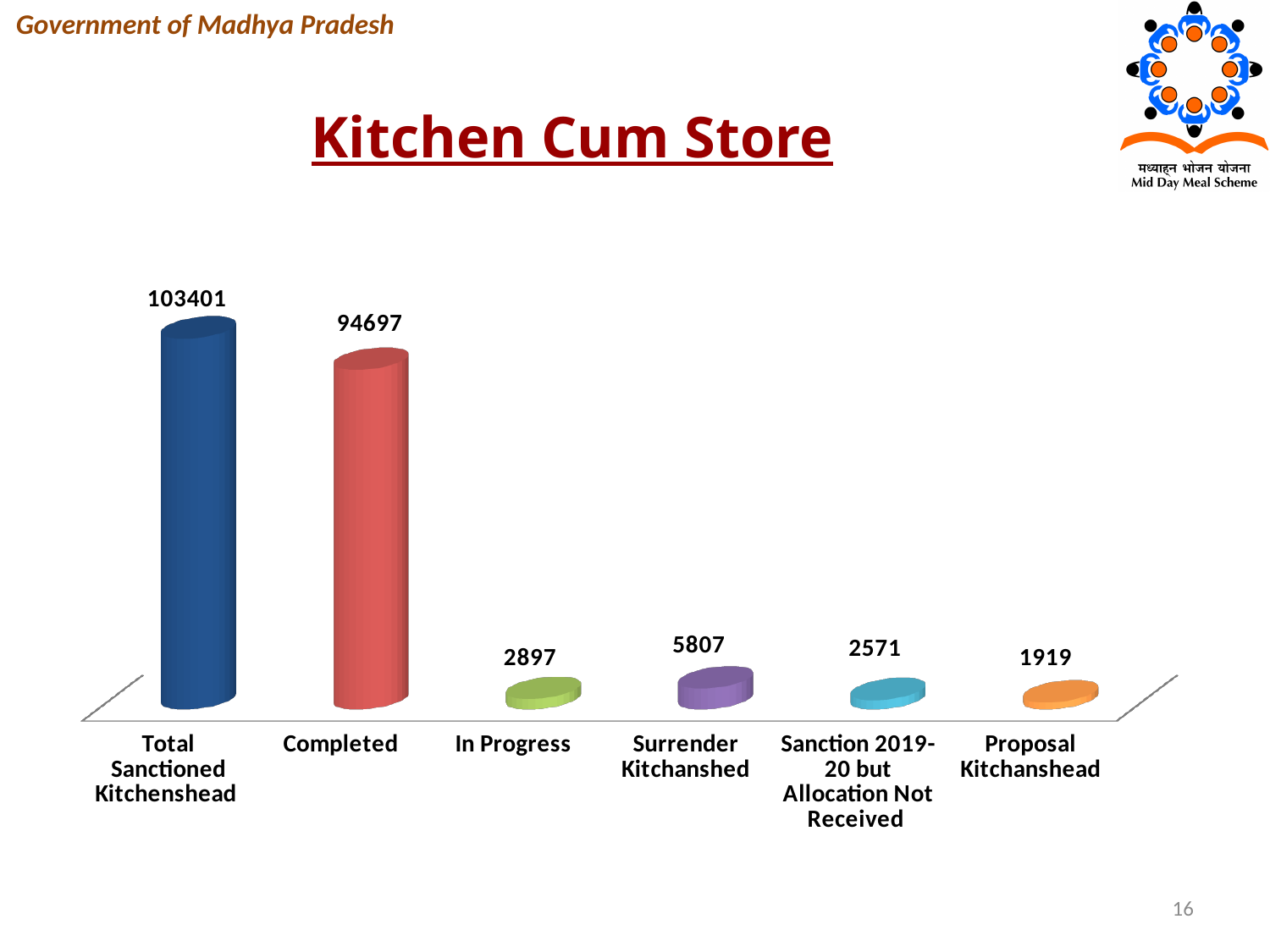
How many categories are shown in the chart? 6 What is the value for Surrender Kitchanshed? 5807 What is the value for In Progress? 2897 What is the value for Proposal Kitchanshead? 1919 What is the difference between Total Sanctioned Kitchenshead and Completed? 8704 Which is larger, Sanction 2019-20 but Allocation Not Received or In Progress? In Progress What is the value for Total Sanctioned Kitchenshead? 103401 What is the difference between Surrender Kitchanshed and In Progress? 2910 Which category has the lowest value? Proposal Kitchanshead Which category has the highest value? Total Sanctioned Kitchenshead What kind of chart is shown on the slide? Bar chart What is the value for Completed? 94697